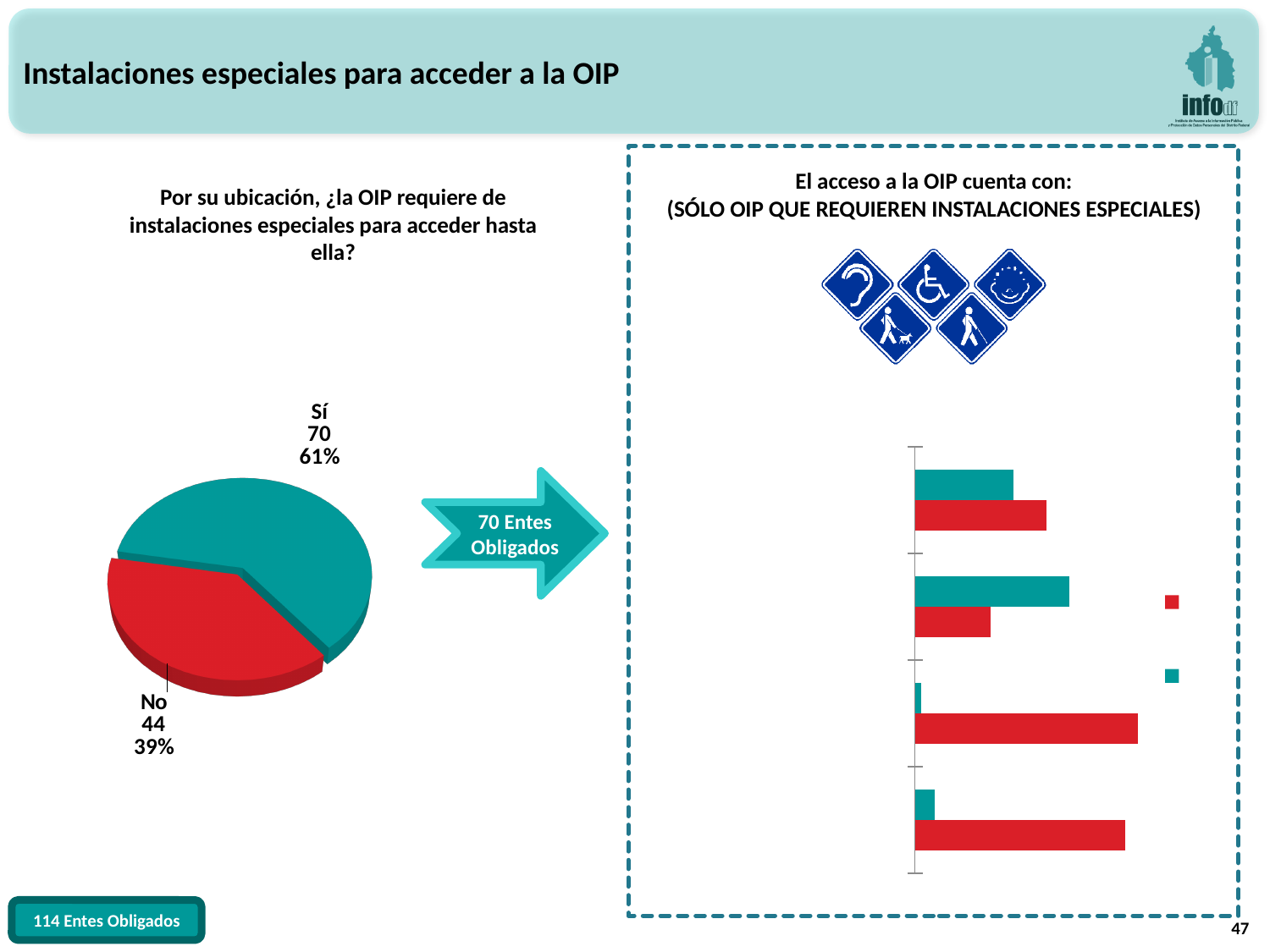
In the pie chart on the left, what percentage share does the "No" slice have? 39% In the pie chart on the left, which category has the smaller slice? No In the pie chart on the left, which category has the larger slice? Sí In the pie chart on the left, how many slices are there? 2 In the bar chart on the right, how many groups of bars are plotted? 4 In the pie chart on the left, what percentage share does the "Sí" slice have? 61% In the pie chart on the left, what is the difference between the number of "Sí" and "No" responses? 26 In the bar chart on the right, how many series does the legend show? 2 In the pie chart on the left, how many entities answered "Sí"? 70 What kind of chart is shown on the left side of the slide? Pie chart In the pie chart on the left, how many entities answered "No"? 44 What kind of chart is shown inside the dashed box on the right side of the slide? Bar chart